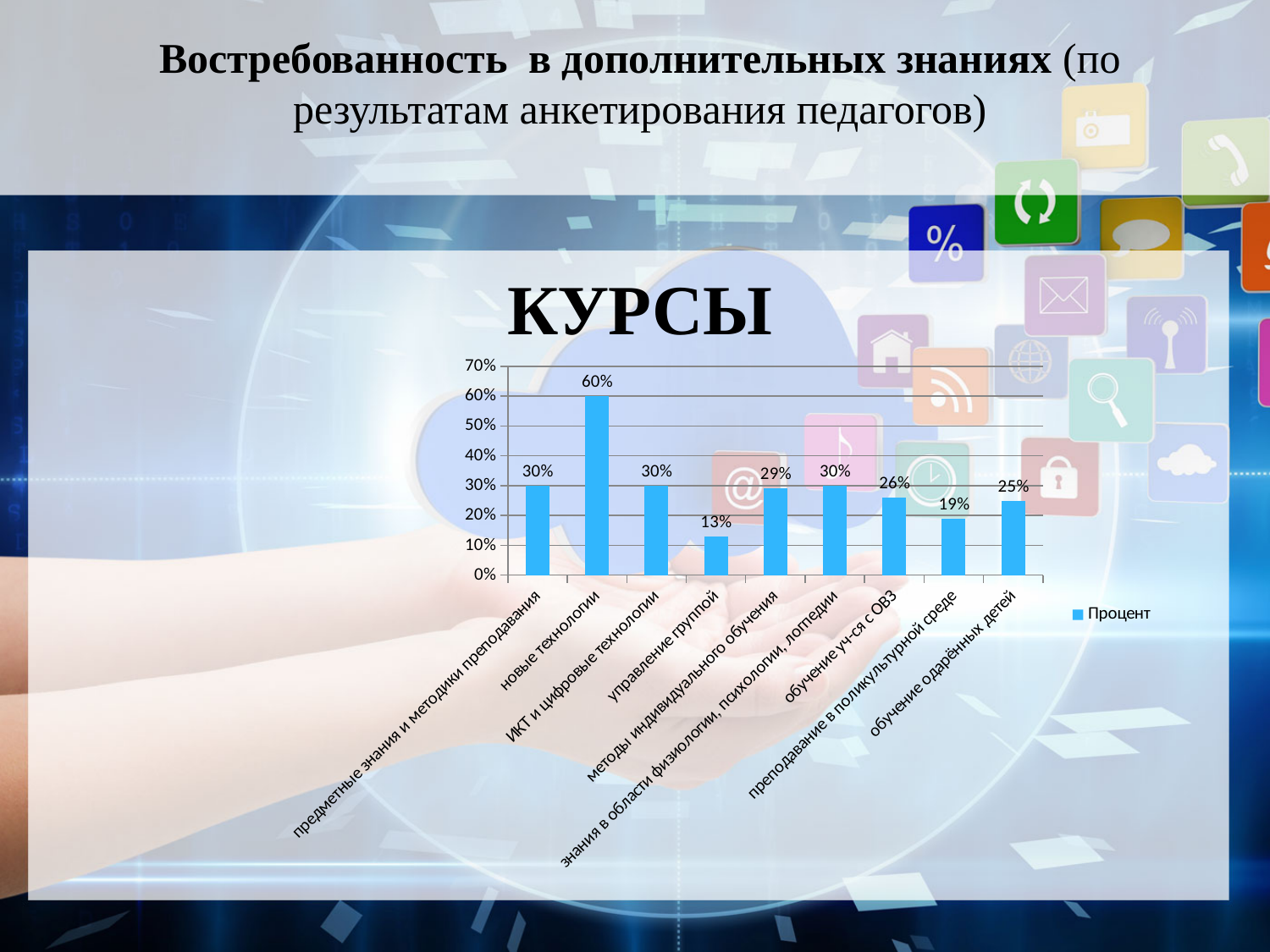
Which category has the lowest value? управление группой What is the value for обучение одарённых детей? 25% What is the difference between the values for новые технологии and управление группой? 47% Which is larger, the value for обучение уч-ся с ОВЗ or the value for преподавание в поликультурной среде? обучение уч-ся с ОВЗ What is the value for обучение уч-ся с ОВЗ? 26% How many categories are shown on the x axis? 9 What is the title of the chart? КУРСЫ What is the value for новые технологии? 60% What is the value for управление группой? 13% Which category has the highest value? новые технологии What is the value for преподавание в поликультурной среде? 19% What kind of chart is this? bar chart